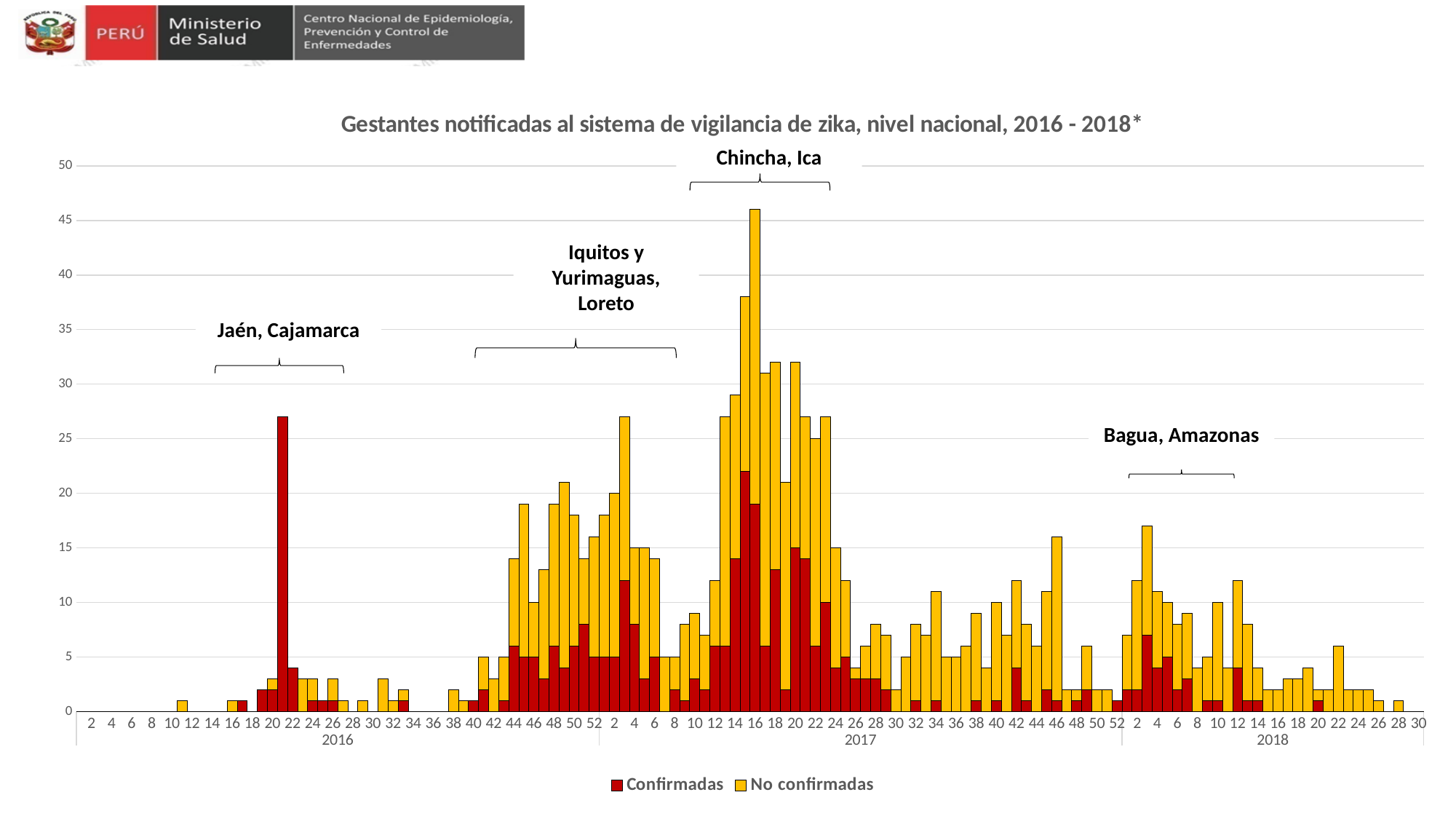
Do the bar totals rise or fall from week 16 to week 30 of 2017? fall What kind of chart is shown on the slide? stacked bar chart Is the total value for week 16 of 2017 greater or less than 40? greater How many series does the legend list? 2 Is the total value for week 21 of 2016 greater or less than 20? greater Is the total value for week 3 of 2018 greater or less than 10? greater What are the two series named in the legend? Confirmadas and No confirmadas In which week and year does the tallest bar occur? week 16 of 2017 Which bar is taller: week 21 of 2016 or week 46 of 2017? week 21 of 2016 Which colour represents the 'Confirmadas' series? red Which bar is taller: week 16 of 2017 or week 21 of 2016? week 16 of 2017